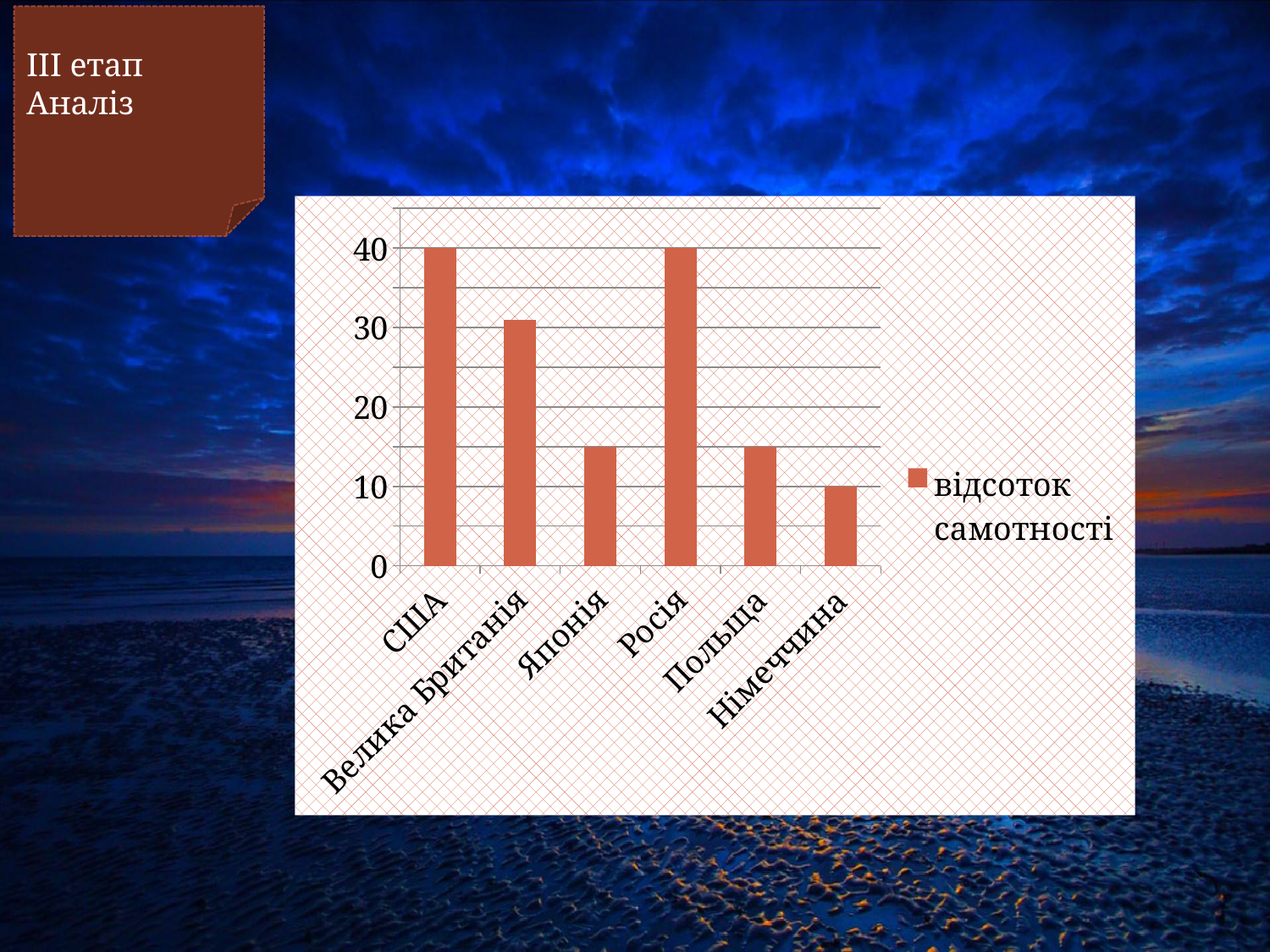
What is the value for США in the chart? 40 How many series does the chart legend list? 1 What is the value for Росія in the chart? 40 Is the value for Японія greater or less than 20? less What is the name of the series shown in the chart legend? відсоток самотності Is the value for Велика Британія greater or less than 30? greater What kind of chart is shown on the slide? bar chart What is the value for Німеччина in the chart? 10 What is the difference between the values for США and Німеччина? 30 How many countries are shown on the x axis of the chart? 6 Which has a larger value, Велика Британія or Польща? Велика Британія Which country has the lowest value in the chart? Німеччина